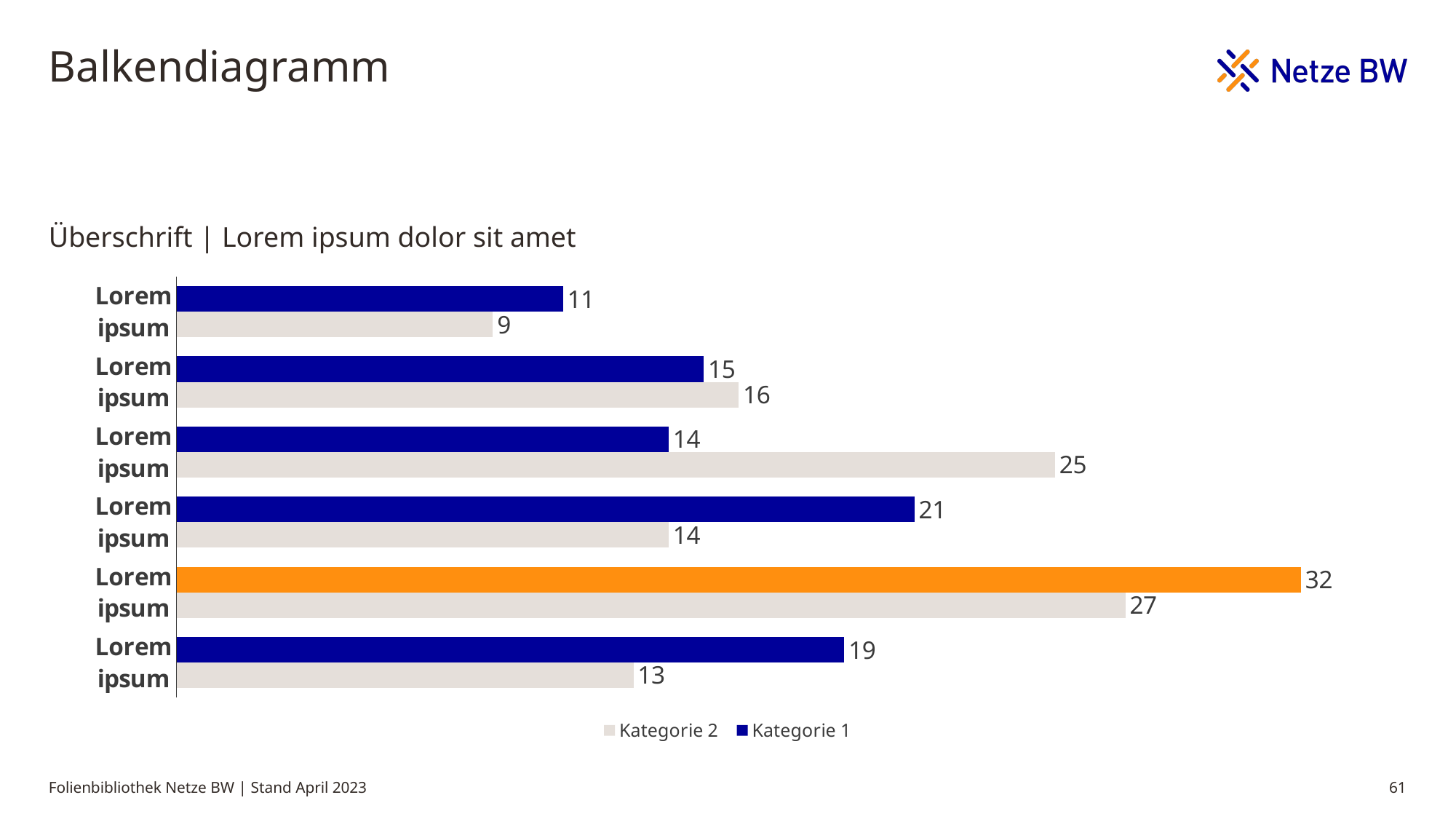
What is the Kategorie 1 value for the topmost category? 11 For the bottom category, which series has the larger value, Kategorie 1 or Kategorie 2? Kategorie 1 Which bar on the chart is highlighted in orange? The Kategorie 1 bar of the fifth category from the top (value 32) What is the Kategorie 2 value for the topmost category? 9 What is the lowest Kategorie 2 value shown on the chart? 9 What is the difference between the Kategorie 1 and Kategorie 2 values for the fifth category from the top? 5 What type of chart is shown on the slide? bar chart How many series does the legend list? 2 How many categories are plotted on the chart? 6 What is the difference between the Kategorie 2 and Kategorie 1 values for the third category from the top? 11 What is the highest Kategorie 1 value shown on the chart? 32 What is the Kategorie 2 value for the third category from the top? 25